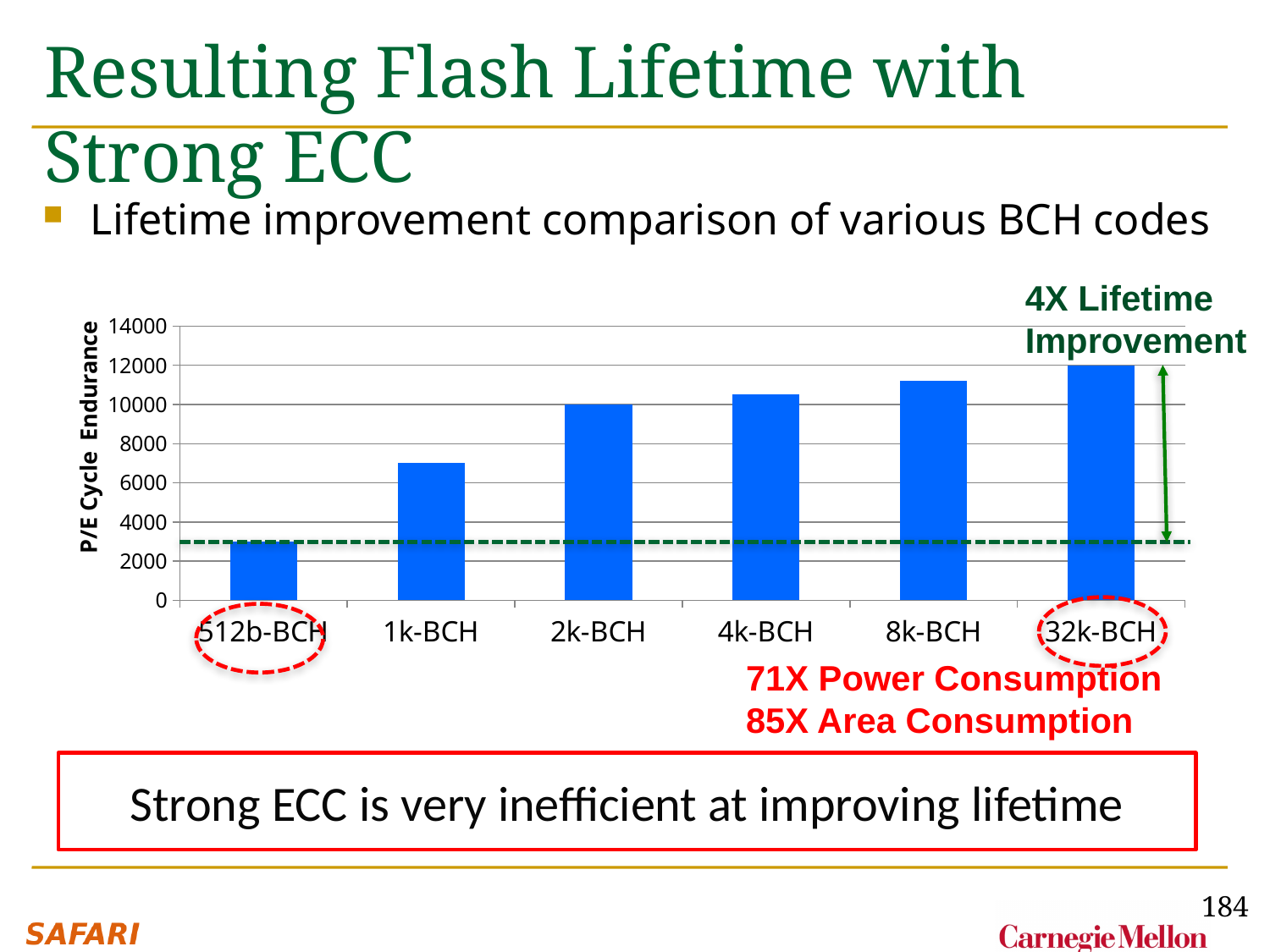
Do the P/E Cycle Endurance values rise or fall from 512b-BCH to 32k-BCH? rise Is the P/E Cycle Endurance for 8k-BCH greater or less than 10000? greater Is the P/E Cycle Endurance for 1k-BCH greater or less than 6000? greater Is the P/E Cycle Endurance for 8k-BCH greater or less than 12000? less Which has a higher P/E Cycle Endurance, 1k-BCH or 2k-BCH? 2k-BCH What is the label on the y axis of the chart? P/E Cycle Endurance How many BCH code categories are plotted on the x axis? 6 What kind of chart is shown on the slide? bar chart Which BCH code has the lowest P/E Cycle Endurance? 512b-BCH Which BCH code has the highest P/E Cycle Endurance? 32k-BCH